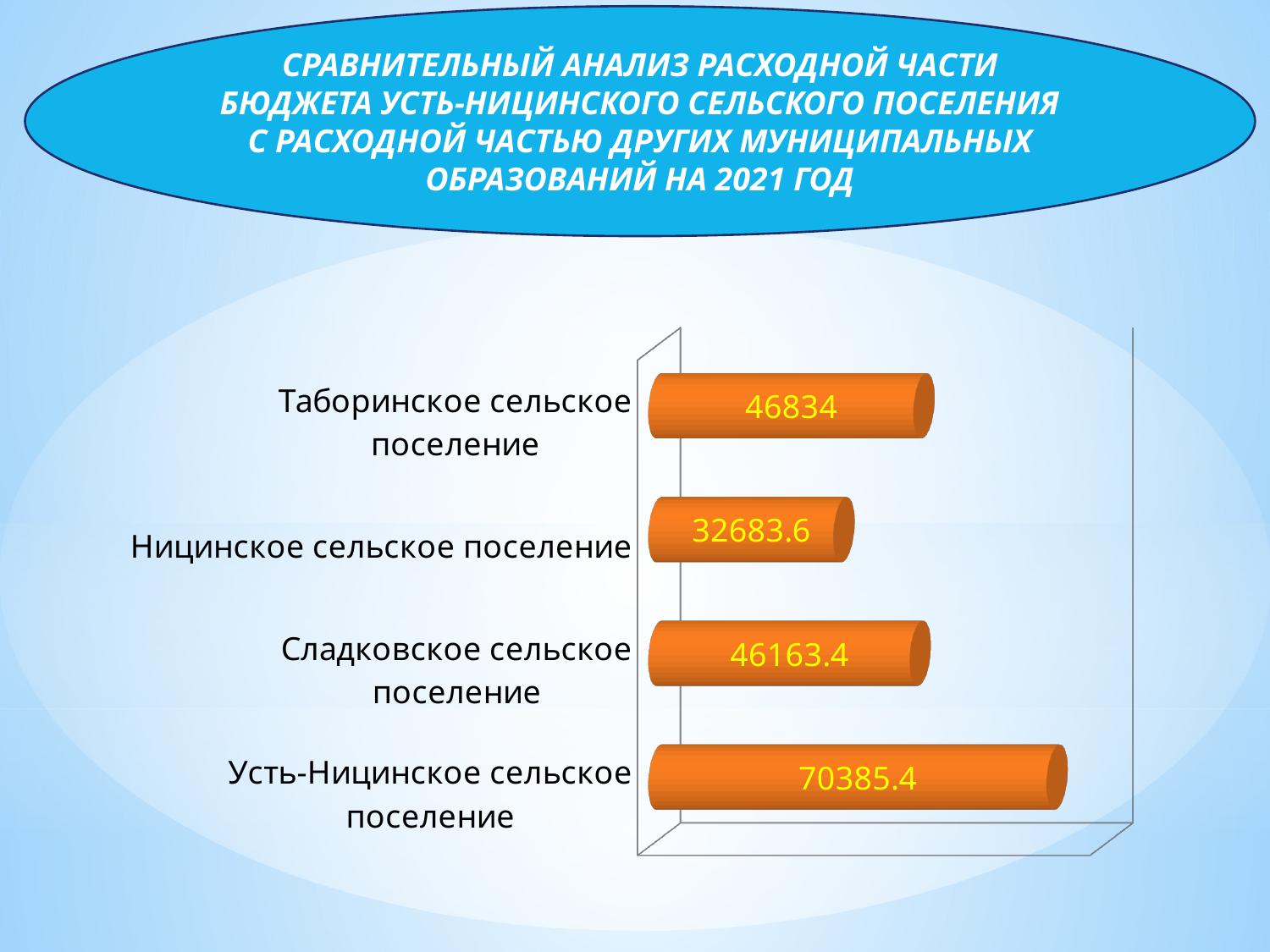
What colour are the bars in the chart? Orange How many settlements are shown in the chart? 4 What is the value for Сладковское сельское поселение? 46163.4 What is the value for Таборинское сельское поселение? 46834 Which settlement has the lowest value? Ницинское сельское поселение What kind of chart is shown on the slide? Bar chart What is the difference between the values for Усть-Ницинское сельское поселение and Таборинское сельское поселение? 23551.4 Which settlement has the highest value? Усть-Ницинское сельское поселение Which is larger, the value for Таборинское сельское поселение or Сладковское сельское поселение? Таборинское сельское поселение What is the difference between the values for Усть-Ницинское сельское поселение and Ницинское сельское поселение? 37701.8 What is the value for Усть-Ницинское сельское поселение? 70385.4 What is the value for Ницинское сельское поселение? 32683.6